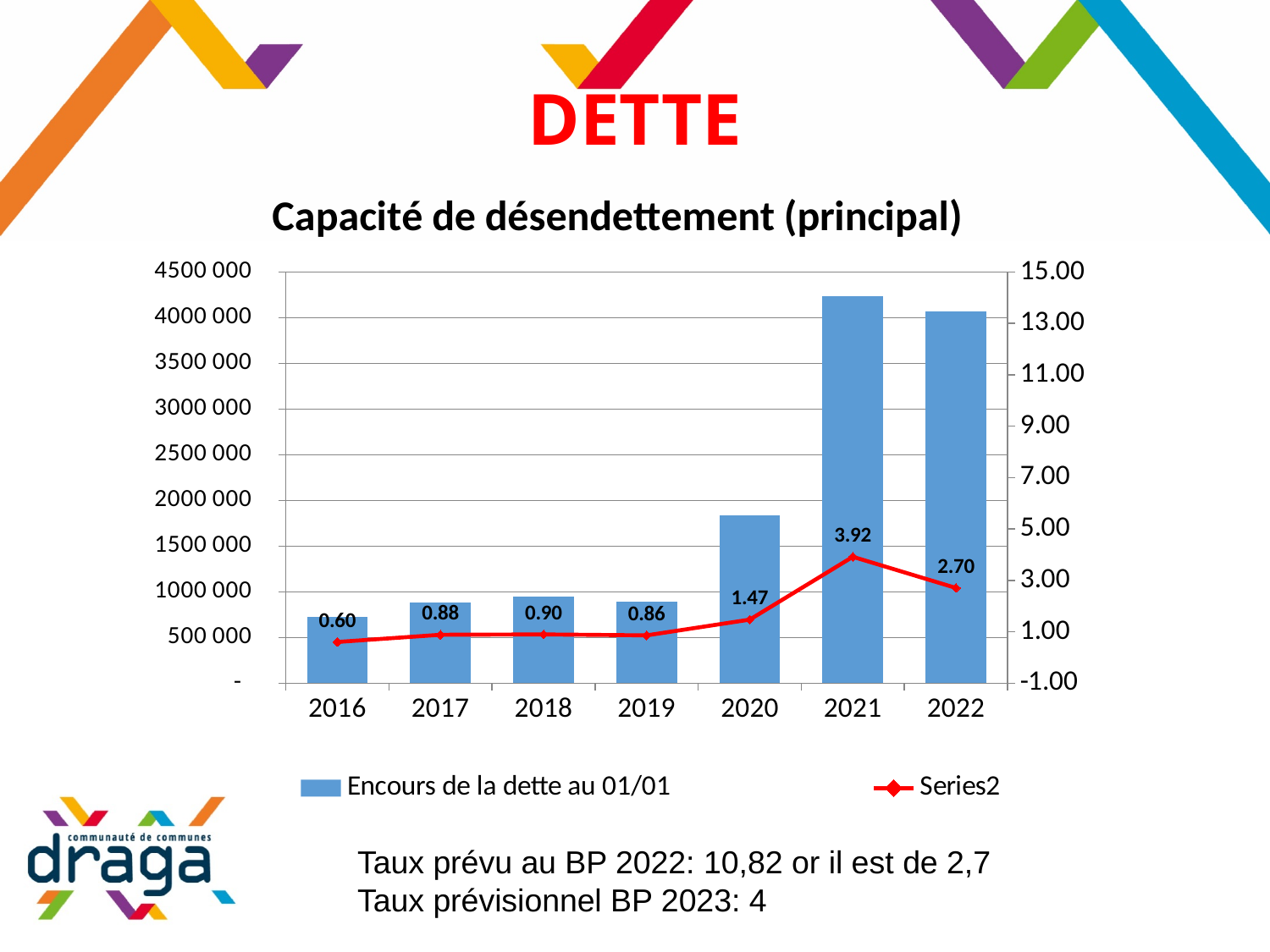
How many series does the legend list? 2 What is the title of the chart? Capacité de désendettement (principal) How many years are shown on the x axis? 7 What is the difference between the Series2 values for 2021 and 2022? 1.22 What is the Series2 value for 2016? 0.60 Is the value of Encours de la dette au 01/01 for 2016 greater or less than 1000 000? less In which year is the Series2 value lowest? 2016 Which year has the larger Series2 value, 2018 or 2019? 2018 What is the Series2 value for 2020? 1.47 Is the value of Encours de la dette au 01/01 for 2021 greater or less than 4000 000? greater What is the Series2 value for 2021? 3.92 In which year is the Series2 value highest? 2021